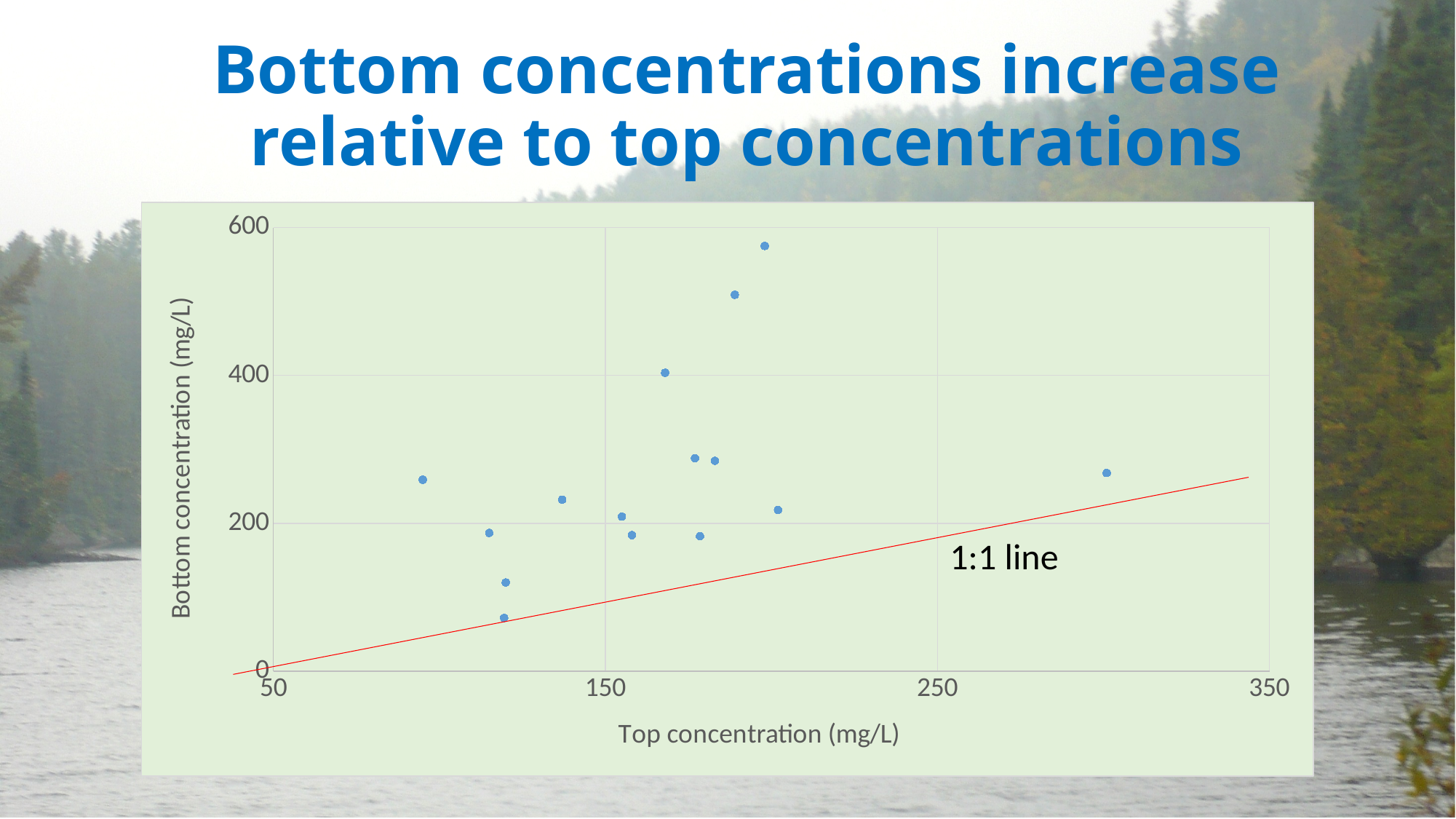
How many data points are plotted on the chart? 15 What is the title of the chart's y axis? Bottom concentration (mg/L) What kind of chart is shown on the slide? Scatter chart What is the maximum value shown on the y axis? 600 Is the highest bottom concentration plotted greater or less than 400? greater Which is larger: the highest bottom concentration plotted or the highest top concentration plotted? The highest bottom concentration Is the largest top concentration plotted greater or less than 250? greater What is the title of the chart's x axis? Top concentration (mg/L) Is the lowest bottom concentration plotted greater or less than 200? less